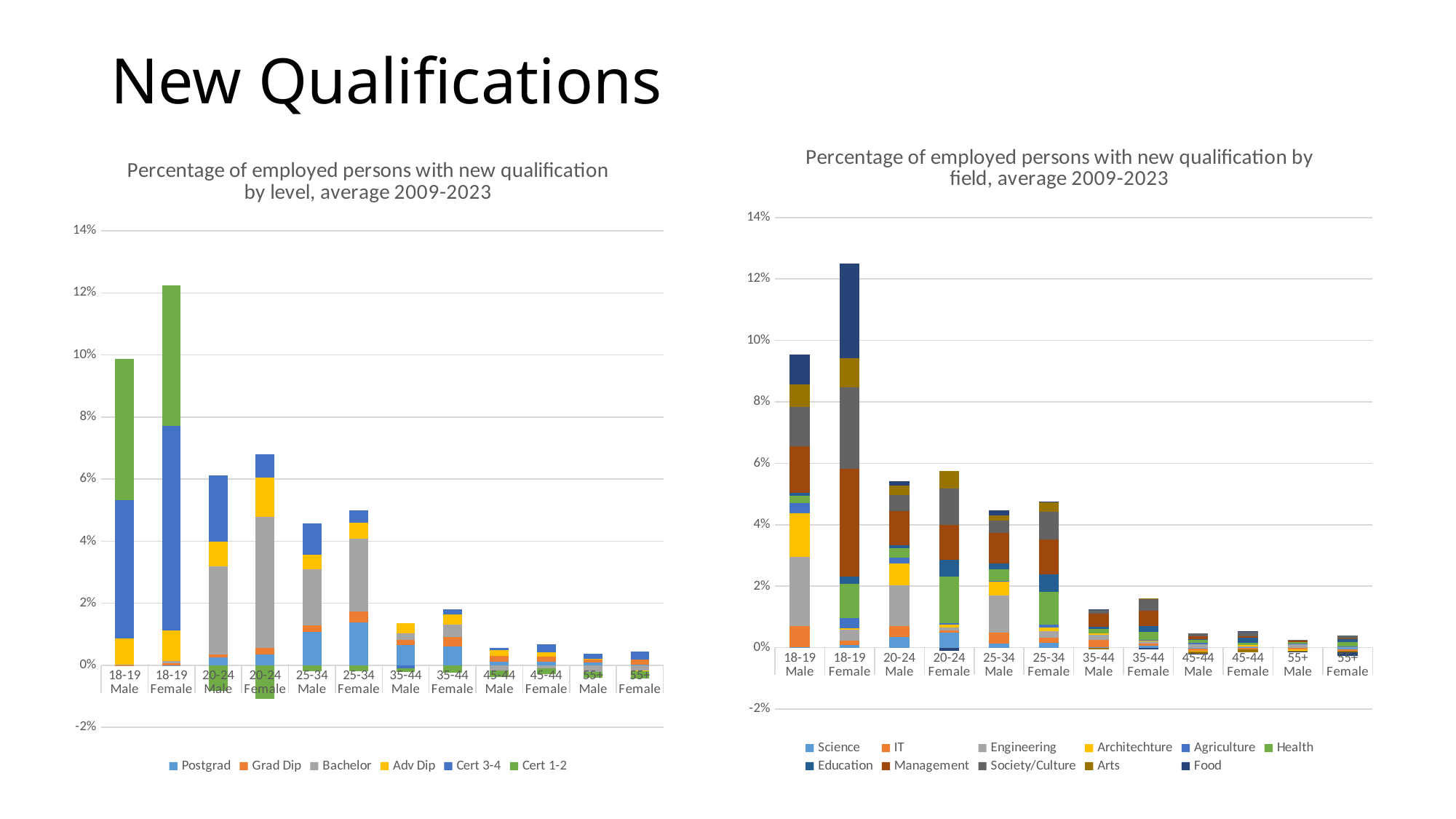
In the left chart (by level), how many series does the legend list? 6 What kind of chart is the left chart, 'Percentage of employed persons with new qualification by level, average 2009-2023'? Stacked bar chart In the left chart (by level), how many age/sex categories are shown on the x axis? 12 In the left chart (by level), is the total for 18-19 Male greater or less than 8%? greater What is the title of the right chart? Percentage of employed persons with new qualification by field, average 2009-2023 In the left chart (by level), is the total for 25-34 Male greater or less than 6%? less In the right chart (by field), is the total for 18-19 Male greater or less than 8%? greater In the right chart (by field), how many series does the legend list? 11 In the right chart (by field), which has the larger total: 20-24 Female or 35-44 Female? 20-24 Female In the right chart (by field), which category has the tallest stacked bar? 18-19 Female In the left chart (by level), which series is shown in green? Cert 1-2 In the left chart (by level), which category has the tallest stacked bar? 18-19 Female